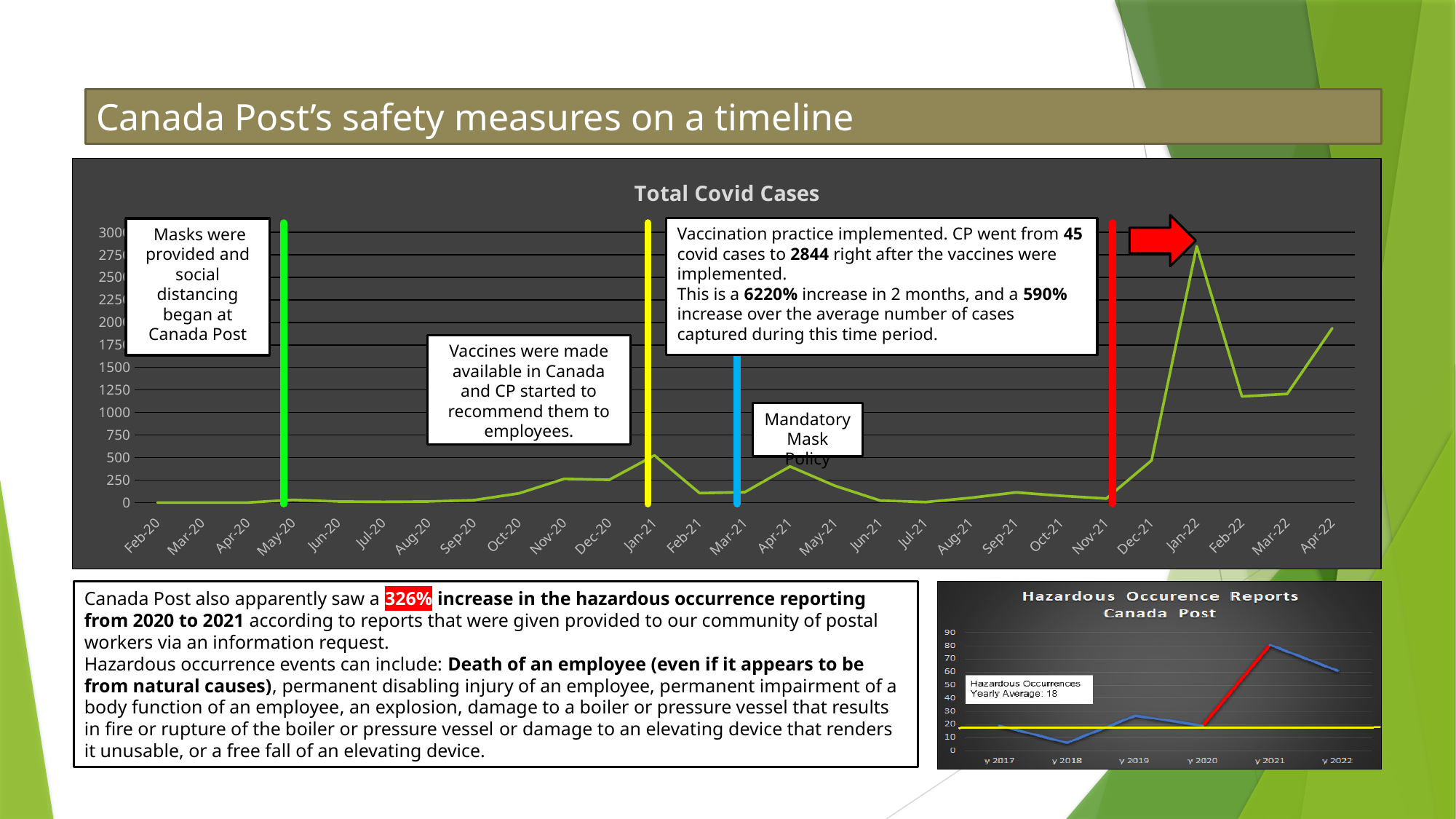
In the "Hazardous Occurence Reports Canada Post" chart, which year has the lowest value? y 2018 In the "Total Covid Cases" chart, is the value for Dec-21 greater or less than 750? less In the "Total Covid Cases" chart, is the value for Jan-22 greater or less than 2500? greater In the "Total Covid Cases" chart, which month has the highest number of cases? Jan-22 How many years are plotted in the "Hazardous Occurence Reports Canada Post" chart? 6 What yearly average of hazardous occurrences is stated in the "Hazardous Occurence Reports Canada Post" chart? 18 In the "Hazardous Occurence Reports Canada Post" chart, which year has the highest value? y 2021 How many months are plotted on the x axis of the "Total Covid Cases" chart? 27 In the "Total Covid Cases" chart, do the values rise or fall from Feb-22 to Apr-22? Rise In the "Total Covid Cases" chart, which is larger, the value for Jan-22 or the value for Feb-22? Jan-22 In the "Total Covid Cases" chart, is the value for Feb-22 greater or less than 1000? greater What type of chart is the "Total Covid Cases" chart? Line chart